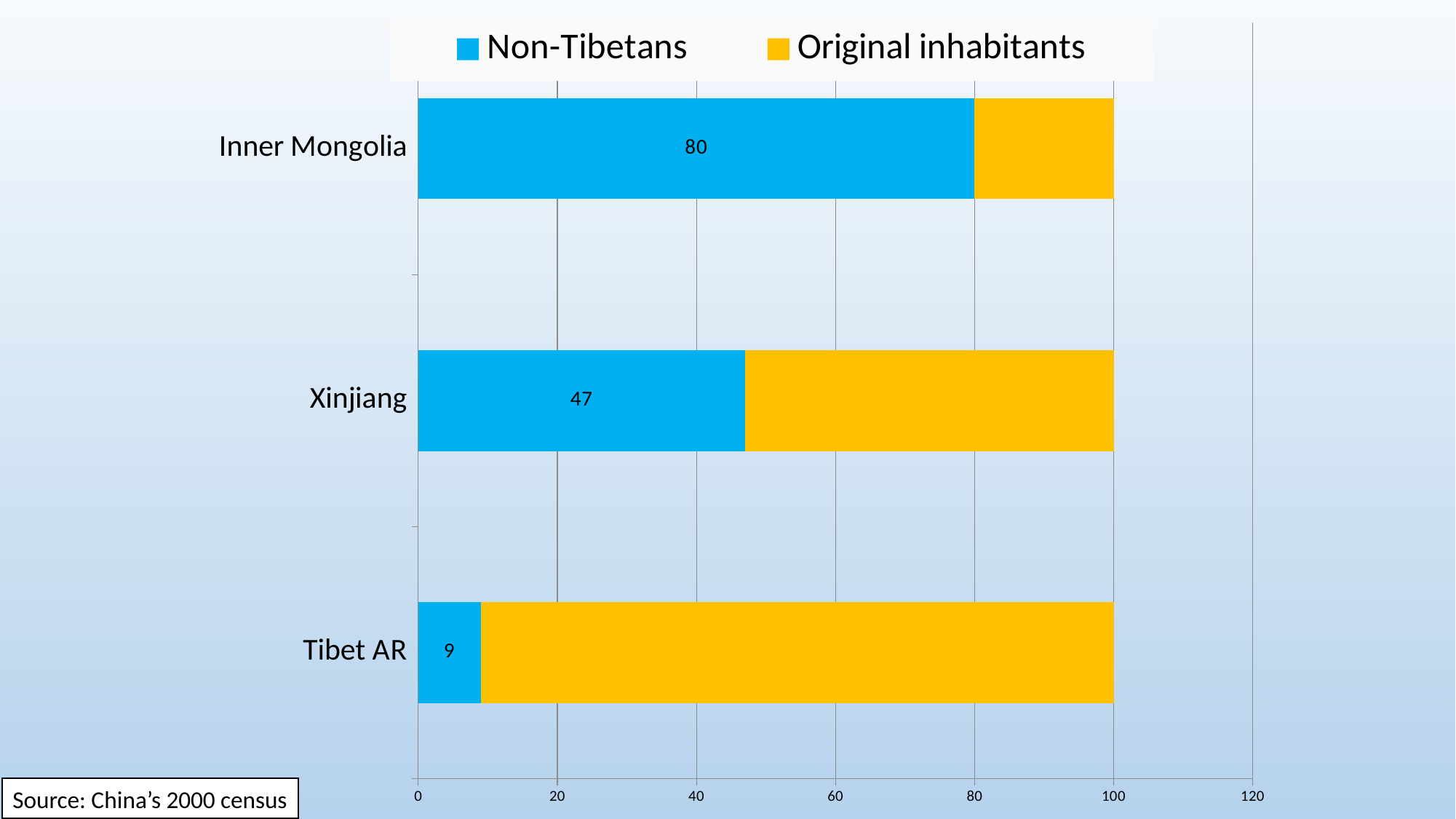
Is the Original inhabitants value for Tibet AR greater or less than 80? greater How many regions are shown on the chart? 3 How many series does the legend list? 2 What kind of chart is shown on the slide? Stacked bar chart What is the Non-Tibetans value for Xinjiang? 47 What is the Non-Tibetans value for Inner Mongolia? 80 What is the difference between the Non-Tibetans values for Inner Mongolia and Xinjiang? 33 Which has a larger Non-Tibetans value, Xinjiang or Tibet AR? Xinjiang Which region has the highest Non-Tibetans value? Inner Mongolia Which region has the lowest Non-Tibetans value? Tibet AR What is the Non-Tibetans value for Tibet AR? 9 Is the Original inhabitants value for Inner Mongolia greater or less than 40? less